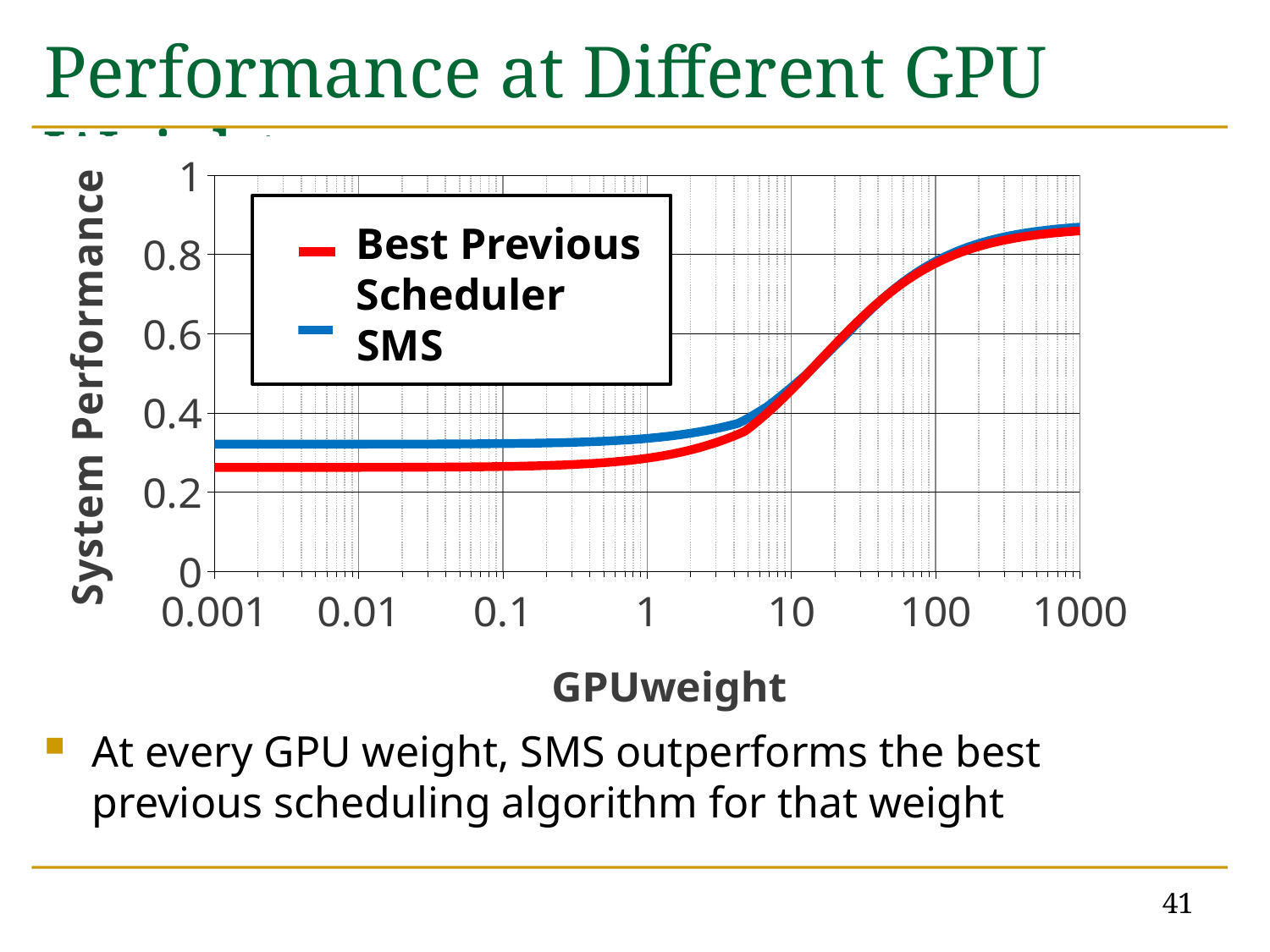
Is the System Performance of SMS at a GPUweight of 0.001 greater or less than 0.2? greater As GPUweight increases from 0.001 to 1000, does the System Performance of SMS rise or fall overall? rise At a GPUweight of 0.001, which series has the higher System Performance, SMS or Best Previous Scheduler? SMS Is the System Performance of SMS at a GPUweight of 0.001 greater or less than 0.4? less How many series does the legend list? 2 What kind of chart is shown on the slide? line chart What is the label of the x axis? GPUweight Which series is drawn in red? Best Previous Scheduler Is the System Performance of the Best Previous Scheduler at a GPUweight of 0.01 greater or less than 0.4? less